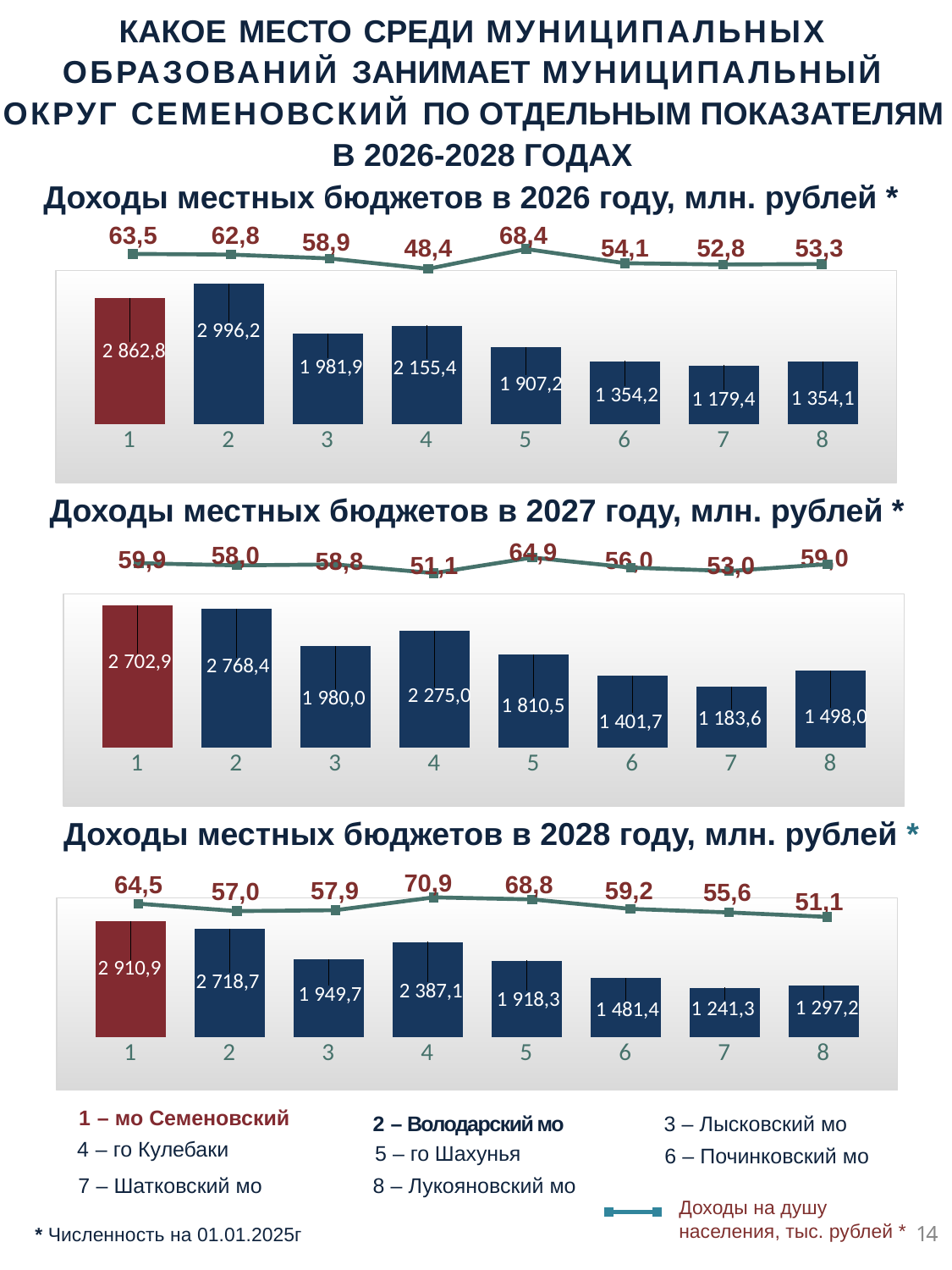
In the chart 'Доходы местных бюджетов в 2027 году', what is the per capita income (line) value for category 5? 64,9 In the chart 'Доходы местных бюджетов в 2027 году', which has the larger bar value, category 3 or category 4? 4 In the chart 'Доходы местных бюджетов в 2028 году', what is the bar value for category 4? 2 387,1 How many categories are shown on the x axis of the chart 'Доходы местных бюджетов в 2028 году'? 8 In the chart 'Доходы местных бюджетов в 2026 году', what is the bar value for category 1? 2 862,8 In the chart 'Доходы местных бюджетов в 2026 году', what is the difference between the bar values for category 2 and category 1? 133,4 In the chart 'Доходы местных бюджетов в 2027 году', which category has the highest per capita income (line) value? 5 In the chart 'Доходы местных бюджетов в 2026 году', which category has the lowest bar? 7 In the chart 'Доходы местных бюджетов в 2026 году', which category has the highest bar? 2 In the chart 'Доходы местных бюджетов в 2028 году', which category has the highest bar? 1 In the chart 'Доходы местных бюджетов в 2028 году', which category has the lowest per capita income (line) value? 8 What kind of chart is 'Доходы местных бюджетов в 2026 году'? Combined bar and line chart